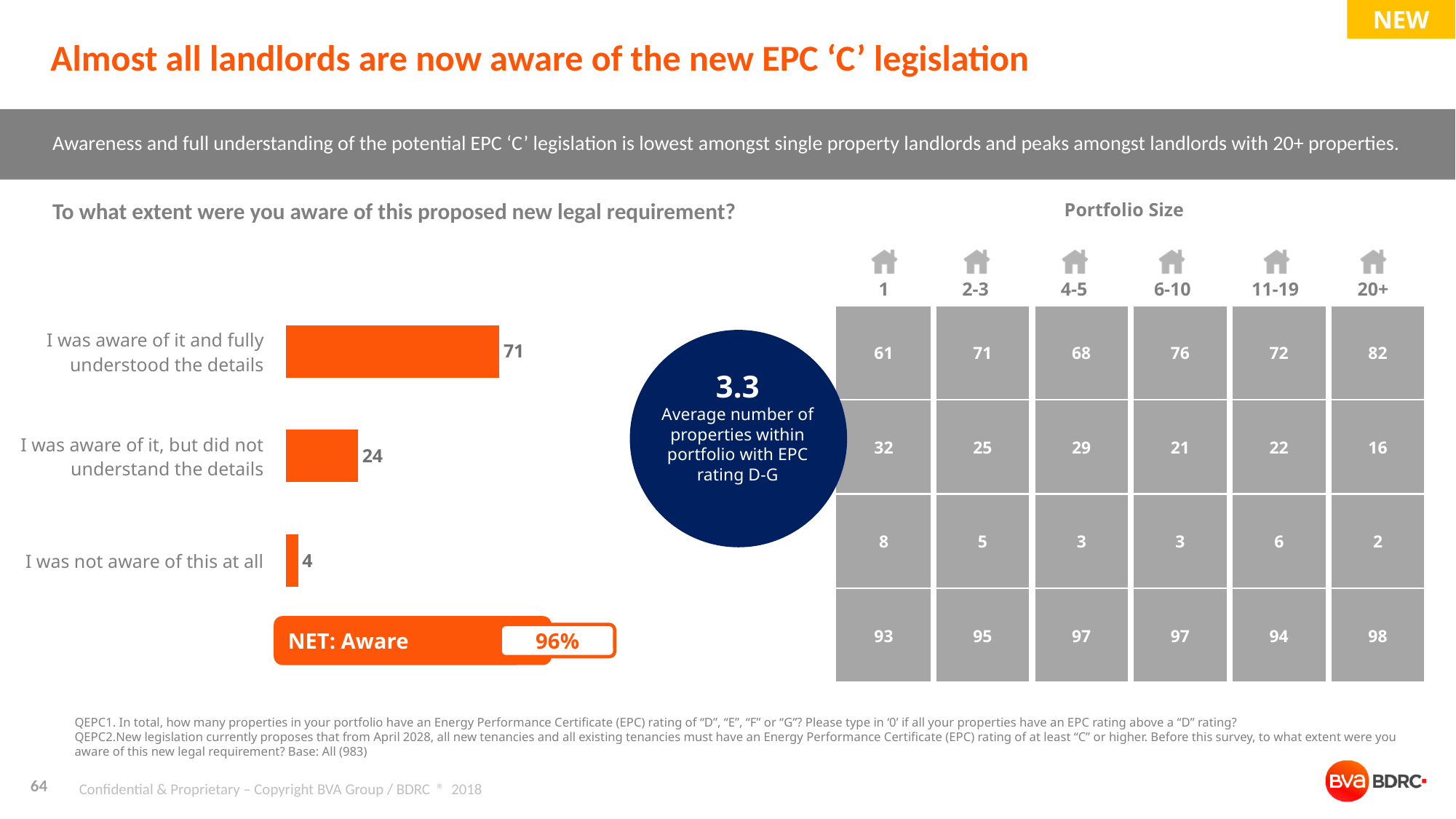
Which category has the highest value in the bar chart? I was aware of it and fully understood the details Which category has the lowest value in the bar chart? I was not aware of this at all What is the difference between the values for "I was aware of it, but did not understand the details" and "I was not aware of this at all"? 20 Which is larger: the value for "I was aware of it, but did not understand the details" or the value for "I was not aware of this at all"? I was aware of it, but did not understand the details How many categories are shown in the bar chart? 3 What value is shown for "I was aware of it and fully understood the details"? 71 What kind of chart is shown on the slide? Bar chart What question is the bar chart answering, according to the heading above it? To what extent were you aware of this proposed new legal requirement? What is the difference between the values for "I was aware of it and fully understood the details" and "I was aware of it, but did not understand the details"? 47 What value is shown for "I was aware of it, but did not understand the details"? 24 What is the NET: Aware figure shown below the bar chart? 96% What value is shown for "I was not aware of this at all"? 4